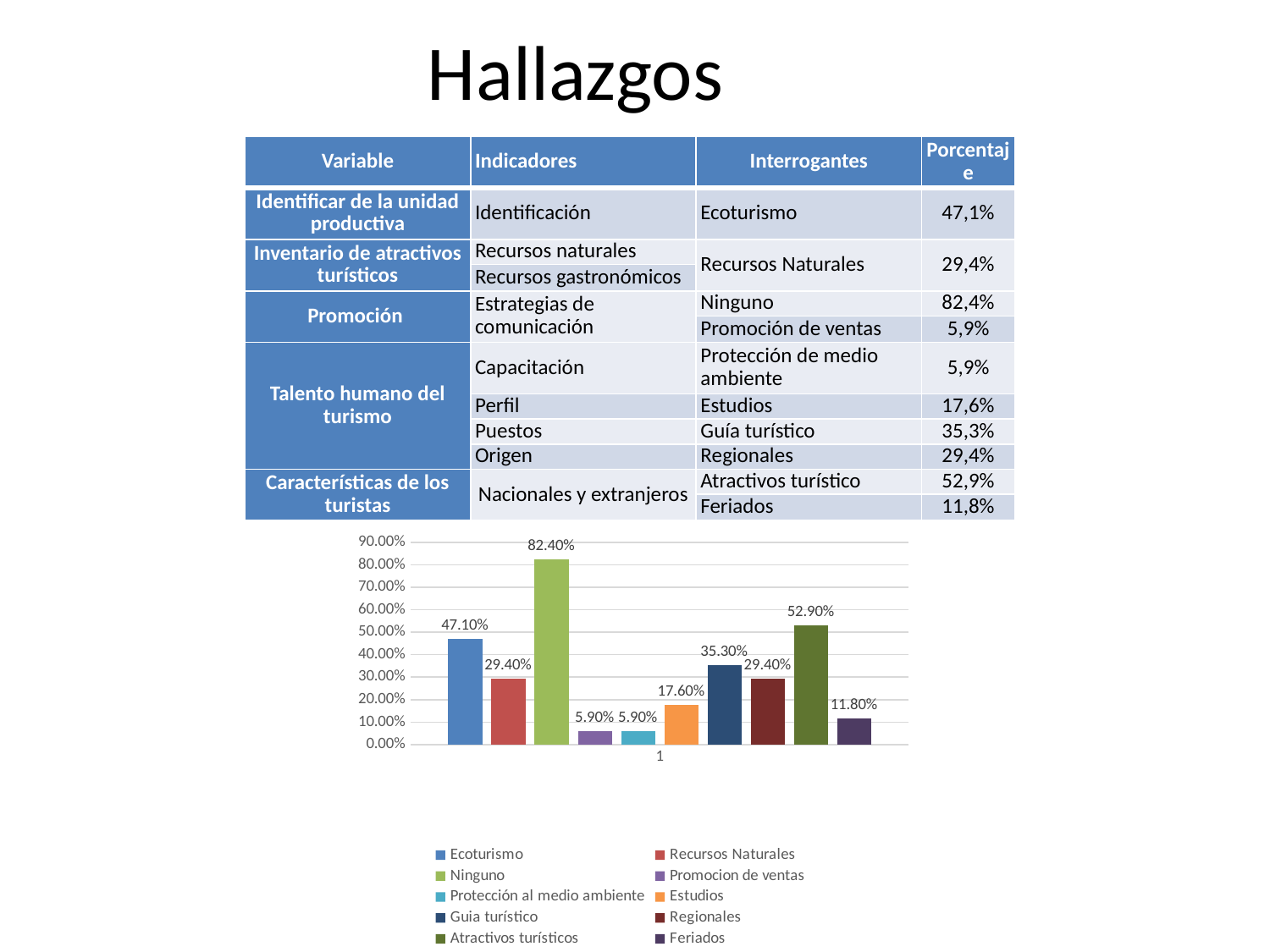
Which is larger, the value for Estudios or the value for Guia turístico? Guia turístico What is the value for Feriados in the chart? 11.80% What is the value for Guia turístico in the chart? 35.30% What is the difference between the values for Ecoturismo and Recursos Naturales? 17.70% How many series does the chart legend list? 10 Is the value for Atractivos turísticos greater or less than 50.00%? greater Which series has the highest value in the chart? Ninguno What is the value for Ninguno in the chart? 82.40% What is the highest value shown on the chart's vertical axis? 90.00% What type of chart is shown on the slide? bar chart What is the value for Ecoturismo in the chart? 47.10% What is the difference between the values for Ninguno and Atractivos turísticos? 29.50%